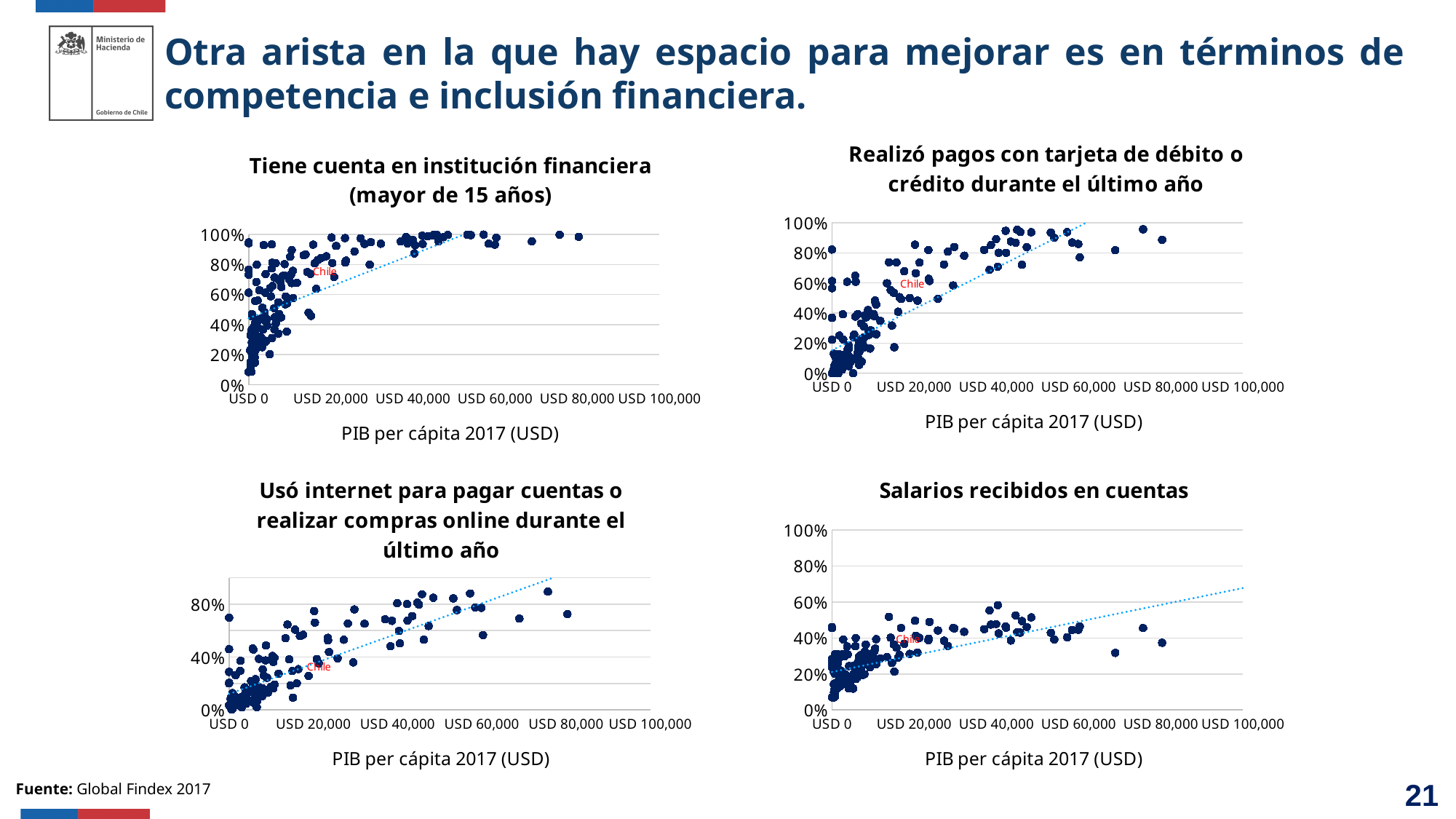
In the chart "Realizó pagos con tarjeta de débito o crédito durante el último año", is the value for Chile greater or less than 40%? greater In the chart "Tiene cuenta en institución financiera (mayor de 15 años)", is the value for Chile greater or less than 60%? greater In the chart "Usó internet para pagar cuentas o realizar compras online durante el último año", is the value for Chile greater or less than 20%? greater In the chart "Tiene cuenta en institución financiera (mayor de 15 años)", do the values generally rise or fall as PIB per cápita increases? rise What kind of chart is "Tiene cuenta en institución financiera (mayor de 15 años)"? scatter chart How many charts are shown on the slide? 4 What is the x-axis label shared by all four charts? PIB per cápita 2017 (USD) In the chart "Usó internet para pagar cuentas o realizar compras online durante el último año", do the values generally rise or fall as PIB per cápita increases? rise In the chart "Salarios recibidos en cuentas", does the dotted trend line rise or fall along the x axis? rise Which country is labelled in red on each of the four charts? Chile